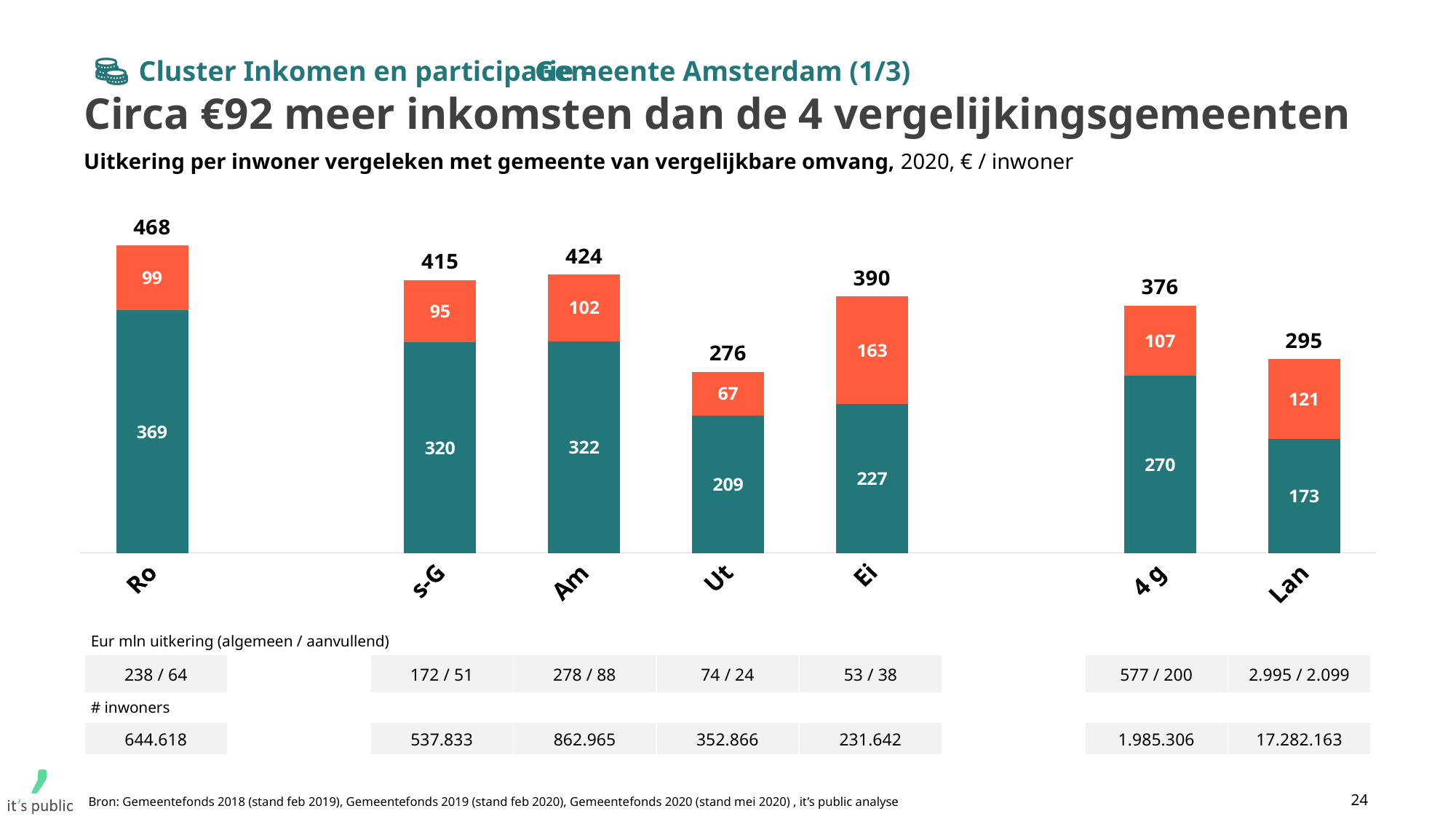
Which category has the lowest total value? Ut What is the difference between the total for Ro and the total for Am? 44 What is the total of the stacked bar for s-G? 415 What is the value of the orange (top) segment of the bar for Ei? 163 Which has a larger orange (top) segment, Ei or 4 g? Ei What kind of chart is shown on the slide? Stacked bar chart Which category has the highest total value? Ro What is the total value shown above the bar for Ro? 468 How many categories are shown on the x axis? 7 What is the difference between the teal (bottom) segments of Ro and Ut? 160 What is the value of the teal (bottom) segment of the bar for Lan? 173 What is the value of the teal (bottom) segment of the bar for Am? 322